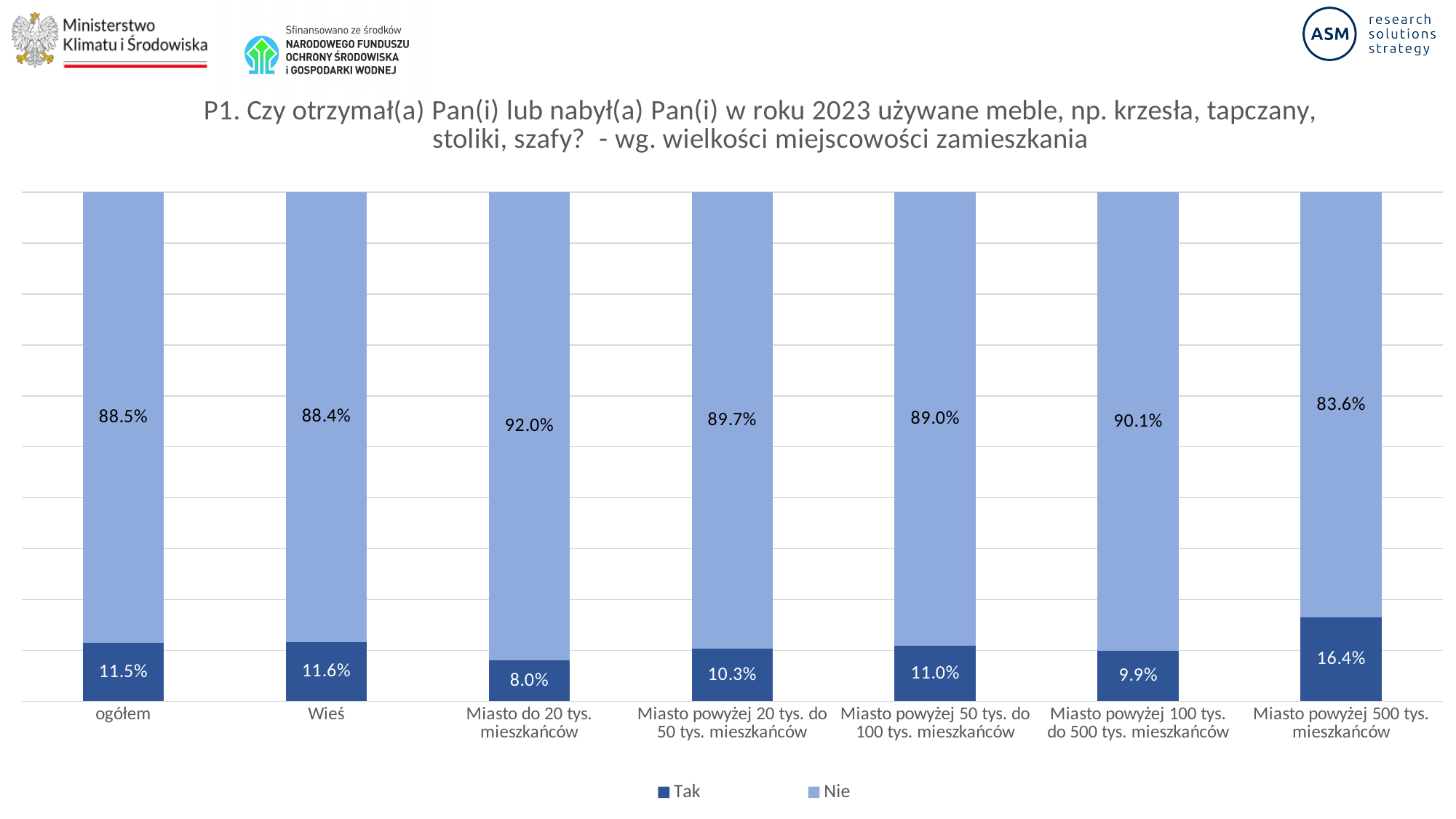
What is the 'Nie' value for 'ogółem'? 88.5% What kind of chart is shown on the slide? Stacked bar chart How many categories are shown on the x axis? 7 Which category has the lowest 'Tak' value? Miasto do 20 tys. mieszkańców Which category has the highest 'Tak' value? Miasto powyżej 500 tys. mieszkańców What is the total of the stacked bar for 'Miasto powyżej 20 tys. do 50 tys. mieszkańców'? 100.0% Which is larger: the 'Tak' value for 'Miasto powyżej 50 tys. do 100 tys. mieszkańców' or for 'Miasto powyżej 100 tys. do 500 tys. mieszkańców'? Miasto powyżej 50 tys. do 100 tys. mieszkańców What is the 'Tak' value for 'Miasto powyżej 500 tys. mieszkańców'? 16.4% How many series does the legend list? 2 What is the 'Nie' value for 'Miasto do 20 tys. mieszkańców'? 92.0% What is the difference between the 'Tak' values for 'Miasto powyżej 500 tys. mieszkańców' and 'Miasto do 20 tys. mieszkańców'? 8.4% What is the 'Tak' value for 'Wieś'? 11.6%